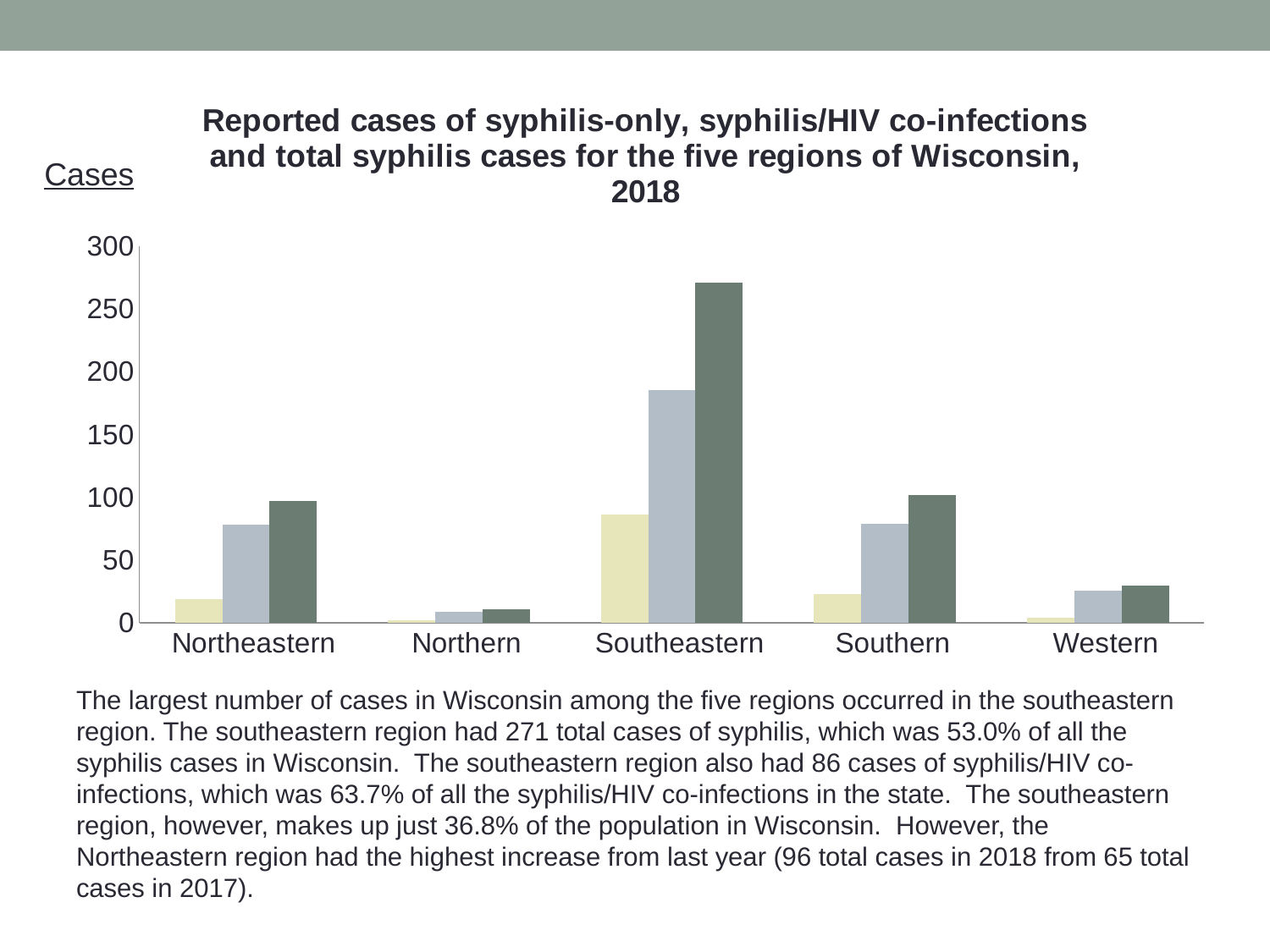
Is the light yellow bar for Southeastern greater or less than 100? less How many bars are plotted for each region? 3 Which region has the tallest dark green bar? Southeastern Is the dark green bar for Western greater or less than 50? less Which region has a taller light blue-gray bar, Southeastern or Southern? Southeastern How many regions are shown on the x axis of the chart? 5 Which region has the shortest dark green bar? Northern What label is shown on the vertical axis of the chart? Cases Is the light blue-gray bar for Southeastern greater or less than 150? greater Which region has a taller dark green bar, Western or Northern? Western What type of chart is shown on the slide? bar chart